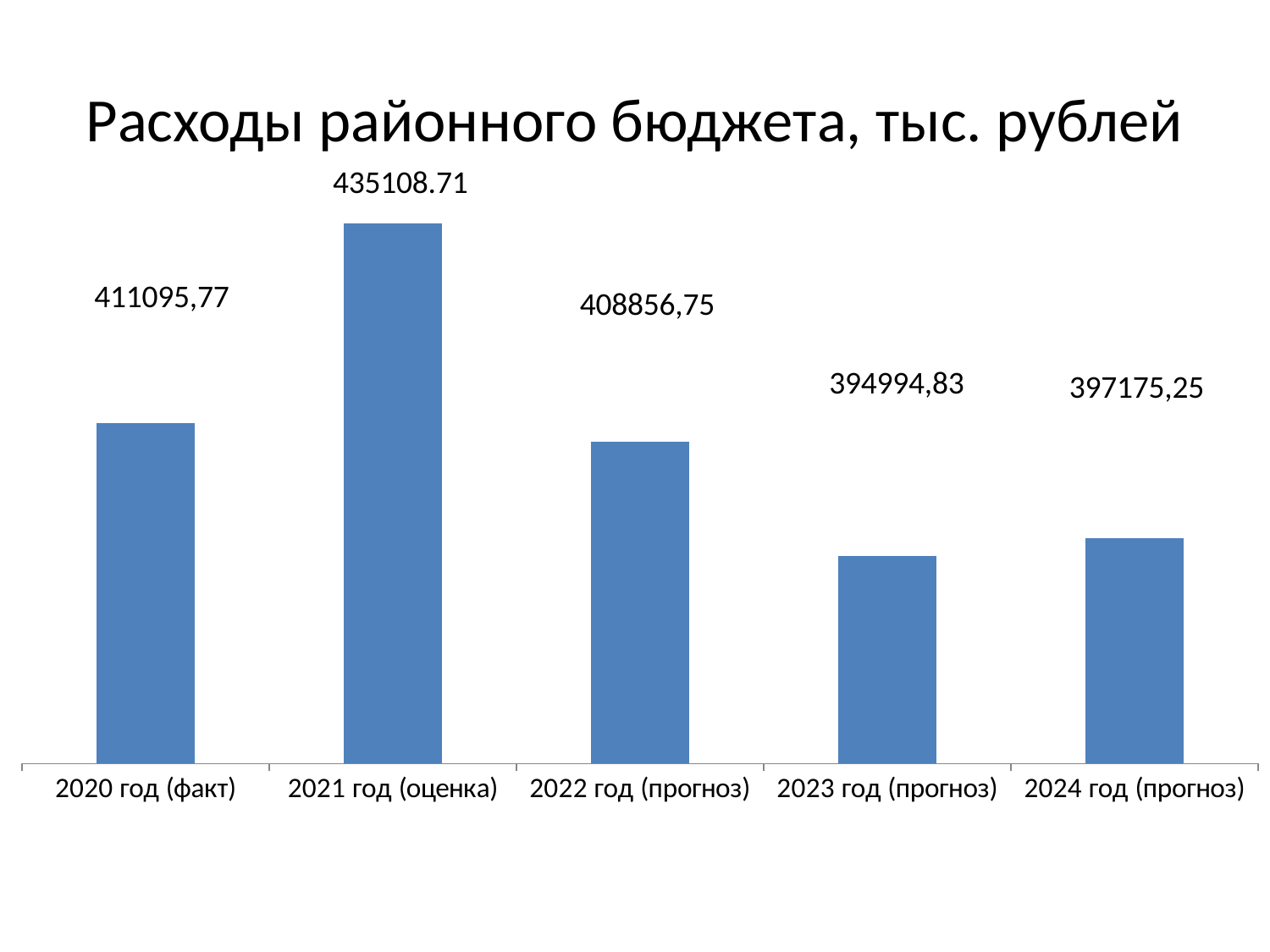
What is the value for 2021 год (оценка)? 435108.71 What kind of chart is shown on the slide? Bar chart What is the difference between the values for 2021 год (оценка) and 2020 год (факт)? 24012,94 What is the value for 2023 год (прогноз)? 394994,83 What is the value for 2020 год (факт)? 411095,77 How many categories are shown on the chart? 5 Which category has the highest value? 2021 год (оценка) What is the title of the chart? Расходы районного бюджета, тыс. рублей What is the value for 2024 год (прогноз)? 397175,25 Which is larger, the value for 2020 год (факт) or 2022 год (прогноз)? 2020 год (факт) Which category has the lowest value? 2023 год (прогноз) Do the values rise or fall from 2021 год (оценка) to 2023 год (прогноз)? Fall